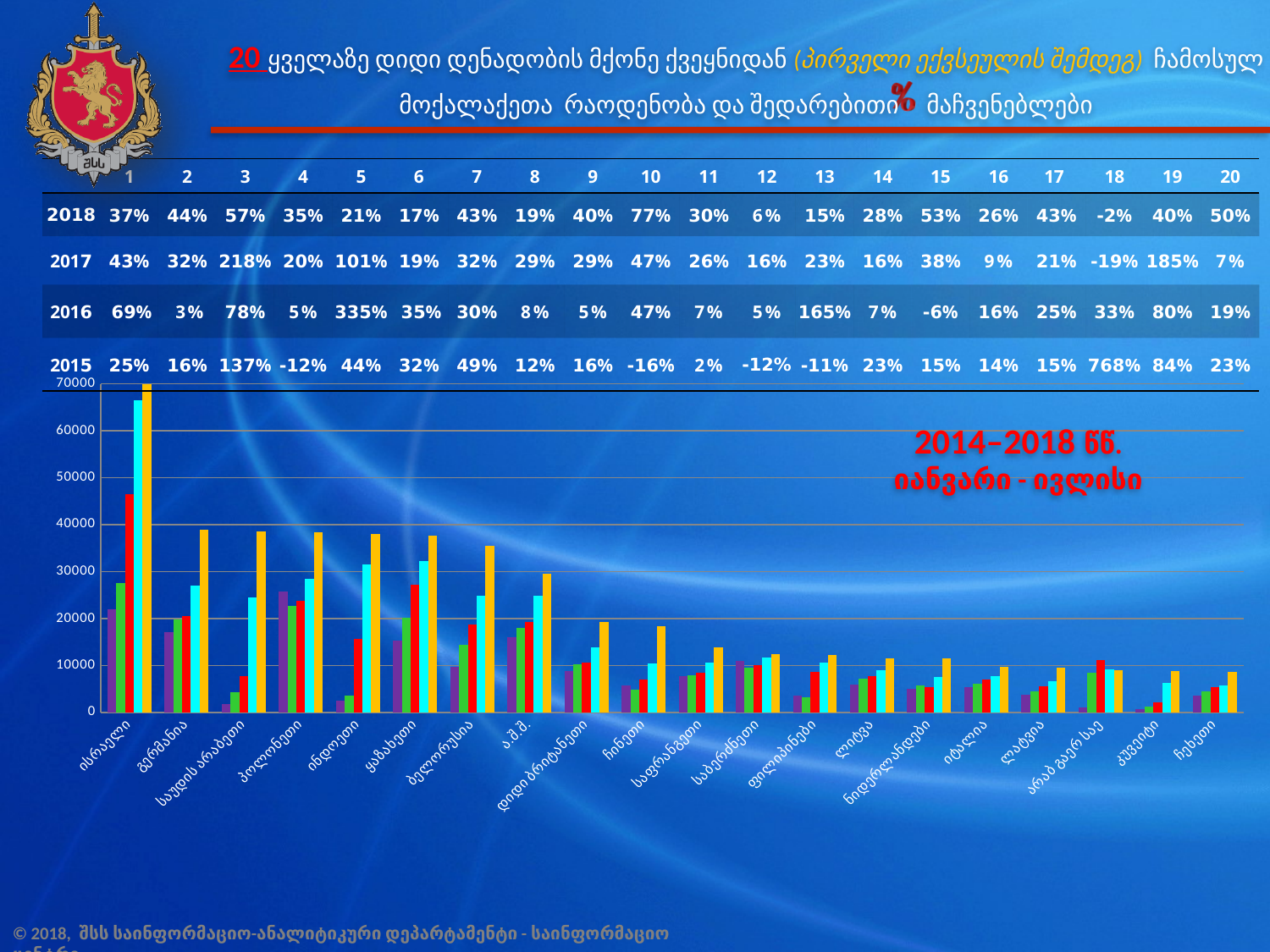
What period is written in red text inside the chart area? 2014-2018 წწ. იანვარი - ივლისი What is the highest value shown on the chart's vertical axis? 70000 Which country has the tallest bars in the chart? ისრაელი Is the yellow bar for ჩინეთი greater or less than 20000? less What kind of chart is shown on the slide? bar chart Which country has a taller yellow bar, ისრაელი or გერმანია? ისრაელი Is the yellow bar for გერმანია greater or less than 30000? greater Do the bar heights generally rise or fall moving from left to right along the x axis? fall Is the tallest (yellow) bar for ისრაელი greater or less than 60000? greater How many bars are plotted for each country in the bar chart? 5 How many countries (categories) are shown on the x axis of the bar chart? 20